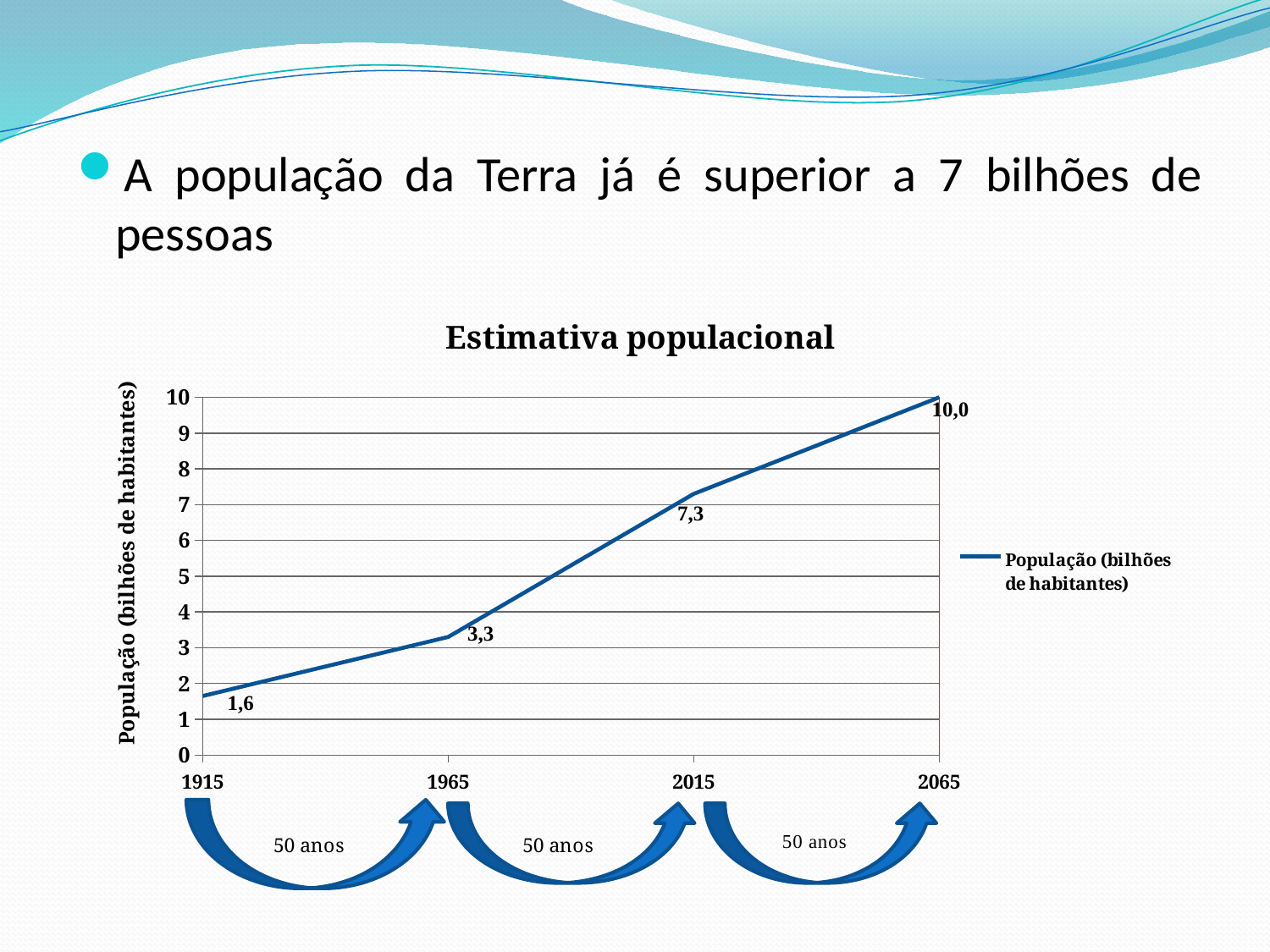
Which year has the highest population value? 2065 What is the population value shown for 1965? 3,3 What is the difference between the population values for 2015 and 1965? 4,0 What is the population value shown for 2015? 7,3 How many series does the legend list? 1 Which is larger, the population value for 1965 or for 2015? 2015 Do the values rise or fall from 1915 to 2065? rise What kind of chart is shown? line chart How many data points are plotted on the line? 4 Which year has the lowest population value? 1915 What is the population value shown for 1915? 1,6 What is the population value shown for 2065? 10,0